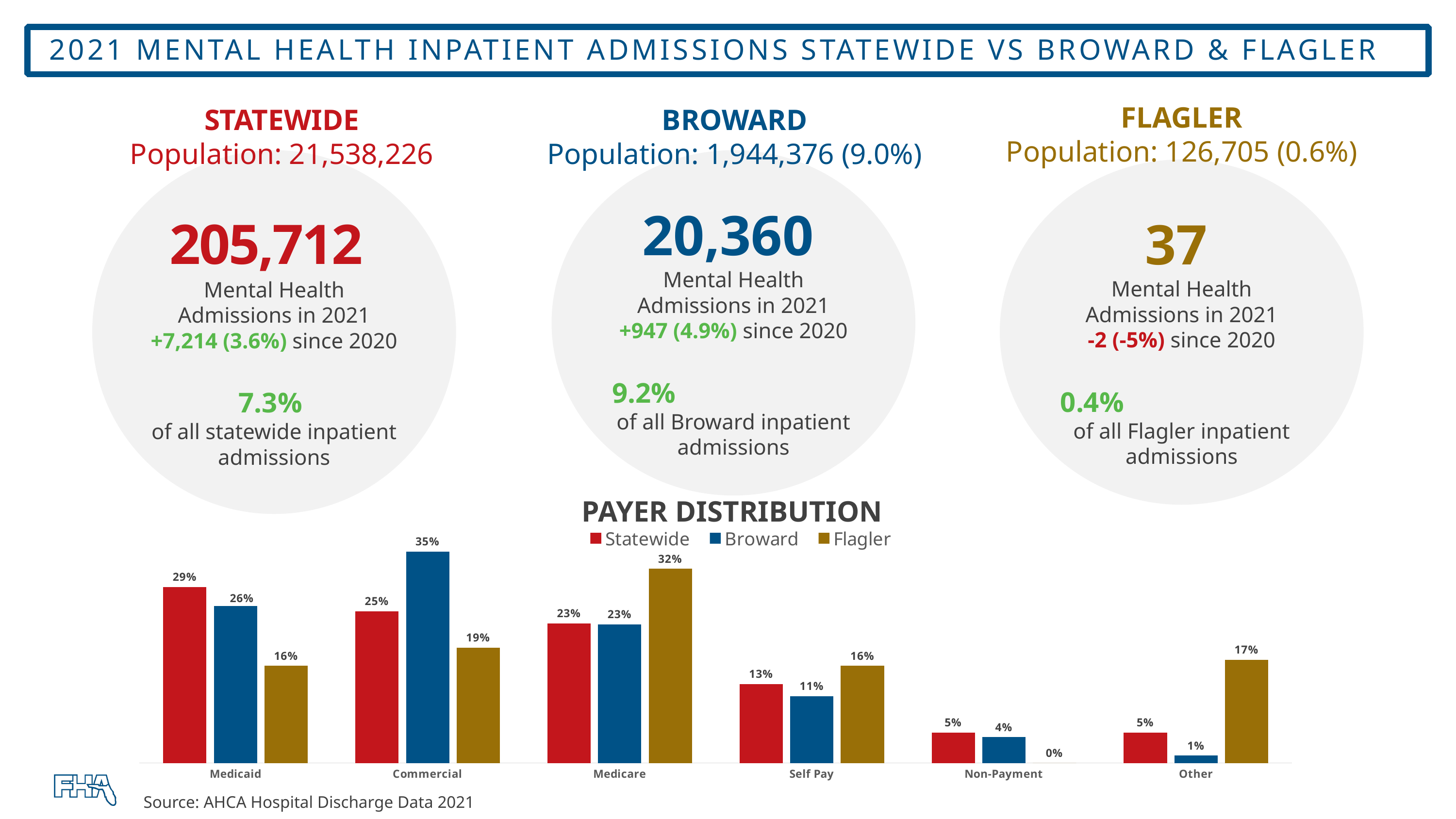
In the Payer Distribution chart, what is the Statewide value for Medicaid? 29% In the Payer Distribution chart, what is the difference between the Flagler and Broward values for Other? 16% In the Payer Distribution chart, what is the Broward value for Commercial? 35% In the Payer Distribution chart, which colour represents the Flagler series? Gold In the Payer Distribution chart, what is the Flagler value for Non-Payment? 0% In the Payer Distribution chart, what is the Flagler value for Medicare? 32% In the Payer Distribution chart, which payer category has the highest Broward value? Commercial In the Payer Distribution chart, which payer category has the lowest Statewide value? Non-Payment and Other (both 5%) How many series does the legend of the Payer Distribution chart list? 3 In the Payer Distribution chart, which is larger for Self Pay: the Statewide value or the Flagler value? Flagler What kind of chart is the Payer Distribution chart? Bar chart How many payer categories are shown on the x axis of the Payer Distribution chart? 6